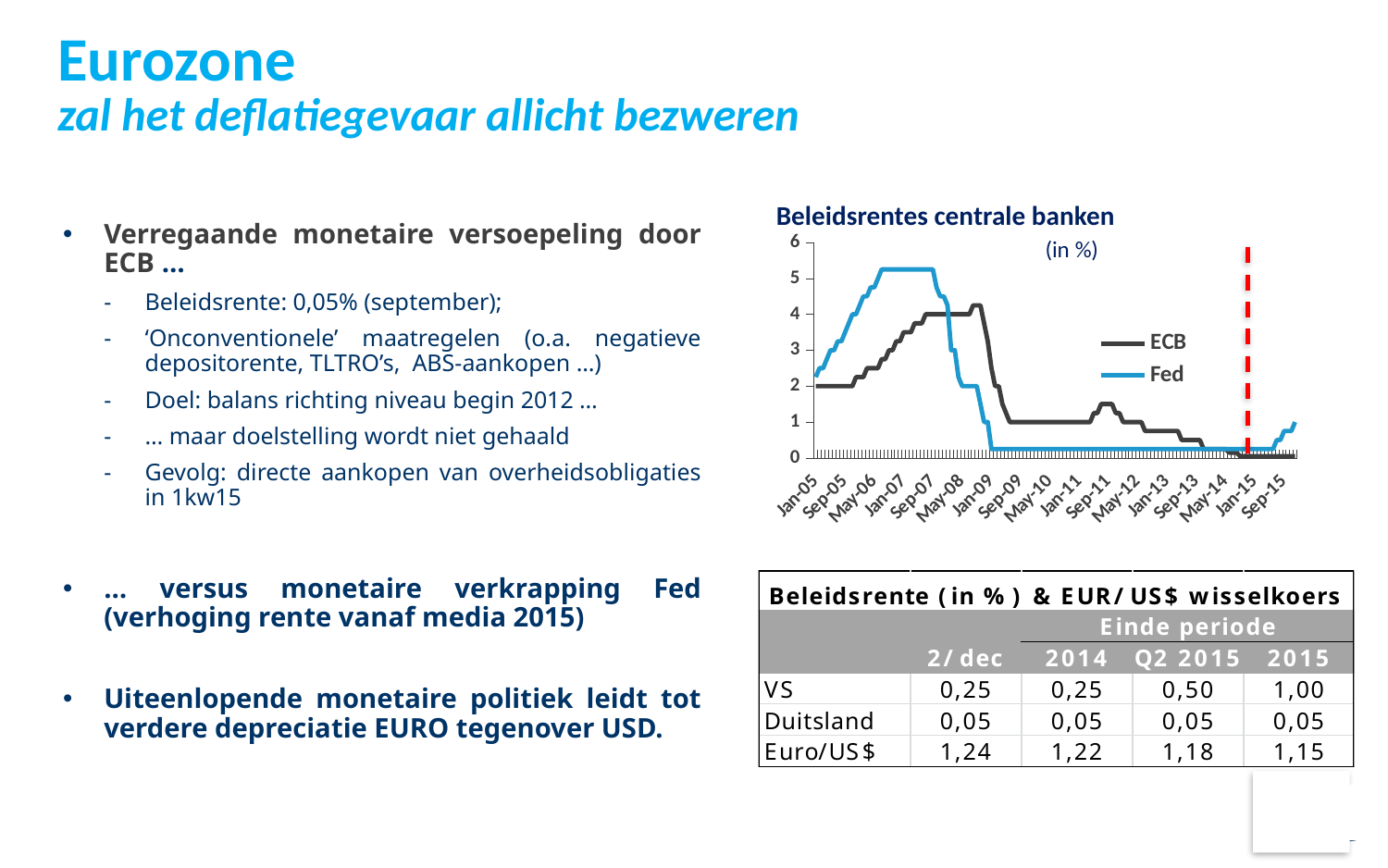
In the 'Beleidsrentes centrale banken' chart, which series reaches the higher peak, ECB or Fed? Fed In the 'Beleidsrentes centrale banken' chart, is the ECB value at Jan-15 greater or less than 1? less In the 'Beleidsrentes centrale banken' chart, is the peak value of the ECB series greater or less than 5? less In the 'Beleidsrentes centrale banken' chart, is the peak value of the Fed series greater or less than 5? greater What is the highest value shown on the y axis of the 'Beleidsrentes centrale banken' chart? 6 What unit is indicated on the 'Beleidsrentes centrale banken' chart? in % What kind of chart is shown under the title 'Beleidsrentes centrale banken'? line chart Which two series are listed in the legend of the 'Beleidsrentes centrale banken' chart? ECB and Fed In the 'Beleidsrentes centrale banken' chart, does the ECB series rise or fall between Sep-08 and Sep-09? fall In the 'Beleidsrentes centrale banken' chart, does the Fed series rise or fall between Jan-05 and Jan-07? rise How many series does the legend of the 'Beleidsrentes centrale banken' chart list? 2